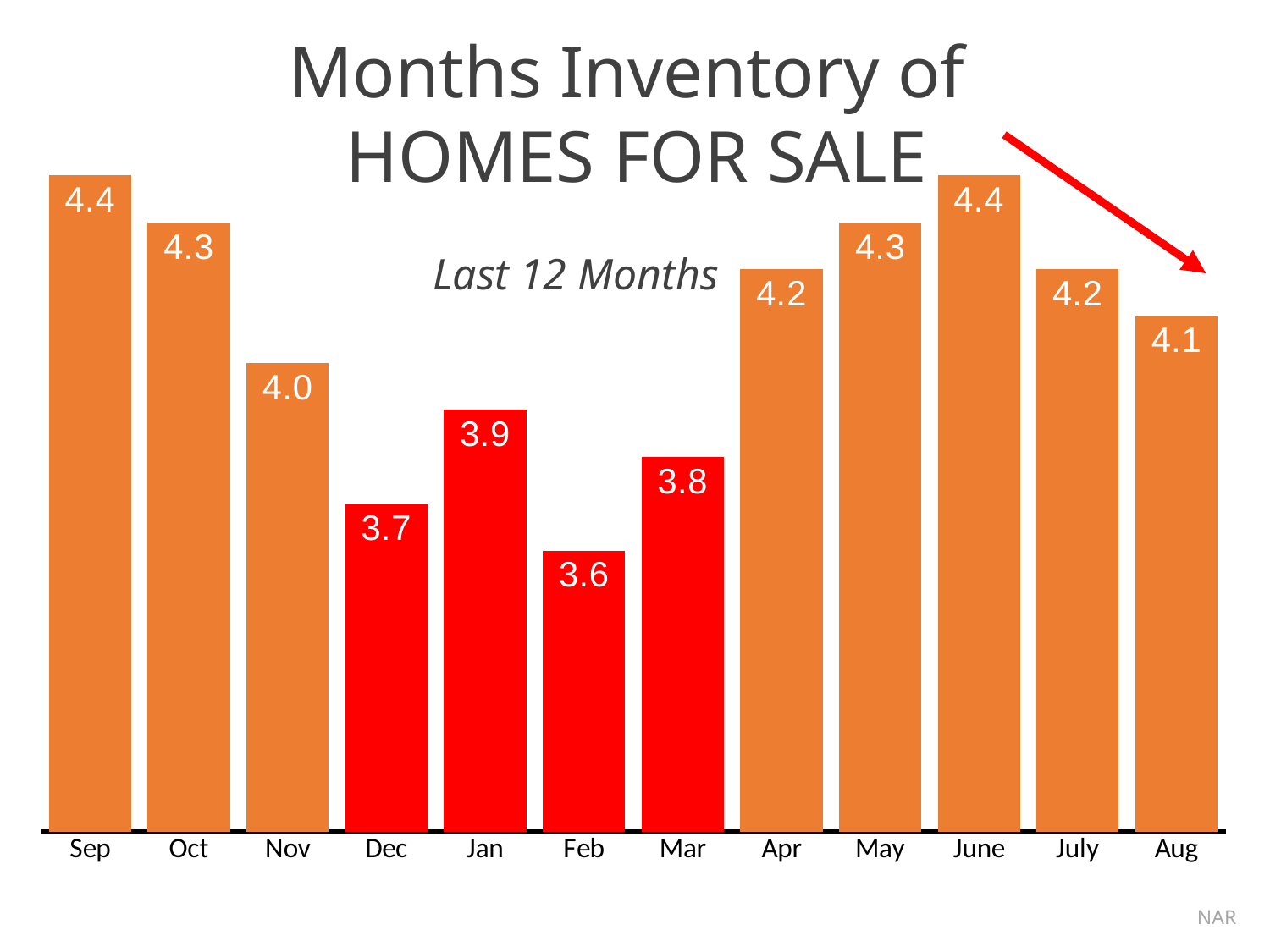
What is the difference between the months inventory for June and for Aug? 0.3 What is the months inventory value for Aug? 4.1 Which is larger, the months inventory for Oct or for Apr? Oct What kind of chart is shown on the slide? Bar chart What is the months inventory value for Feb? 3.6 What is the months inventory value for Nov? 4.0 What is the months inventory value for Jan? 3.9 Which is larger, the months inventory for Dec or for Mar? Mar Which months are shown with red bars instead of orange? Dec, Jan, Feb, Mar Which month has the lowest months inventory of homes for sale? Feb What is the difference between the months inventory for Sep and for Feb? 0.8 How many months are shown on the chart? 12